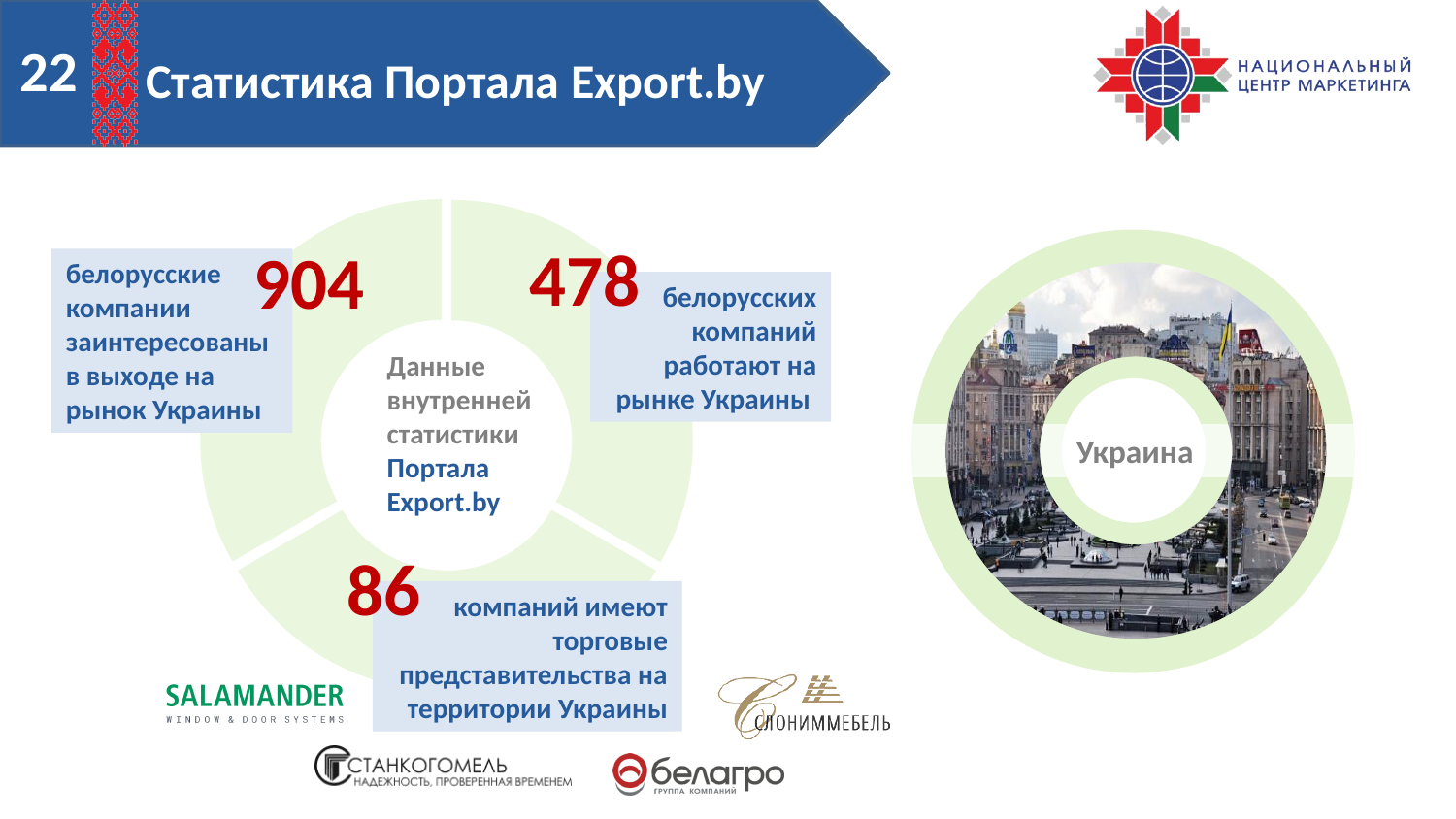
What is the difference between the number of companies interested in entering the Ukrainian market and the number already working on it? 426 How many Belarusian companies work on the Ukrainian market, according to the slide? 478 Which is larger: the number of companies working on the Ukrainian market or the number with trade representations in Ukraine? Companies working on the Ukrainian market (478) What word is written in the centre of the circular image on the right of the slide? Украина Which of the three figures shown in the ring infographic is the smallest? 86 (компаний имеют торговые представительства на территории Украины) How many companies have trade representations on the territory of Ukraine, according to the slide? 86 Which of the three figures shown in the ring infographic is the largest? 904 (белорусские компании заинтересованы в выходе на рынок Украины) What is the title of the slide? Статистика Портала Export.by What is the difference between the number of companies working on the Ukrainian market and the number with trade representations in Ukraine? 392 What is the source of the data stated in the centre of the ring infographic? Данные внутренней статистики Портала Export.by How many Belarusian companies are interested in entering the Ukrainian market, according to the slide? 904 How many segments does the ring infographic on the left have? 3